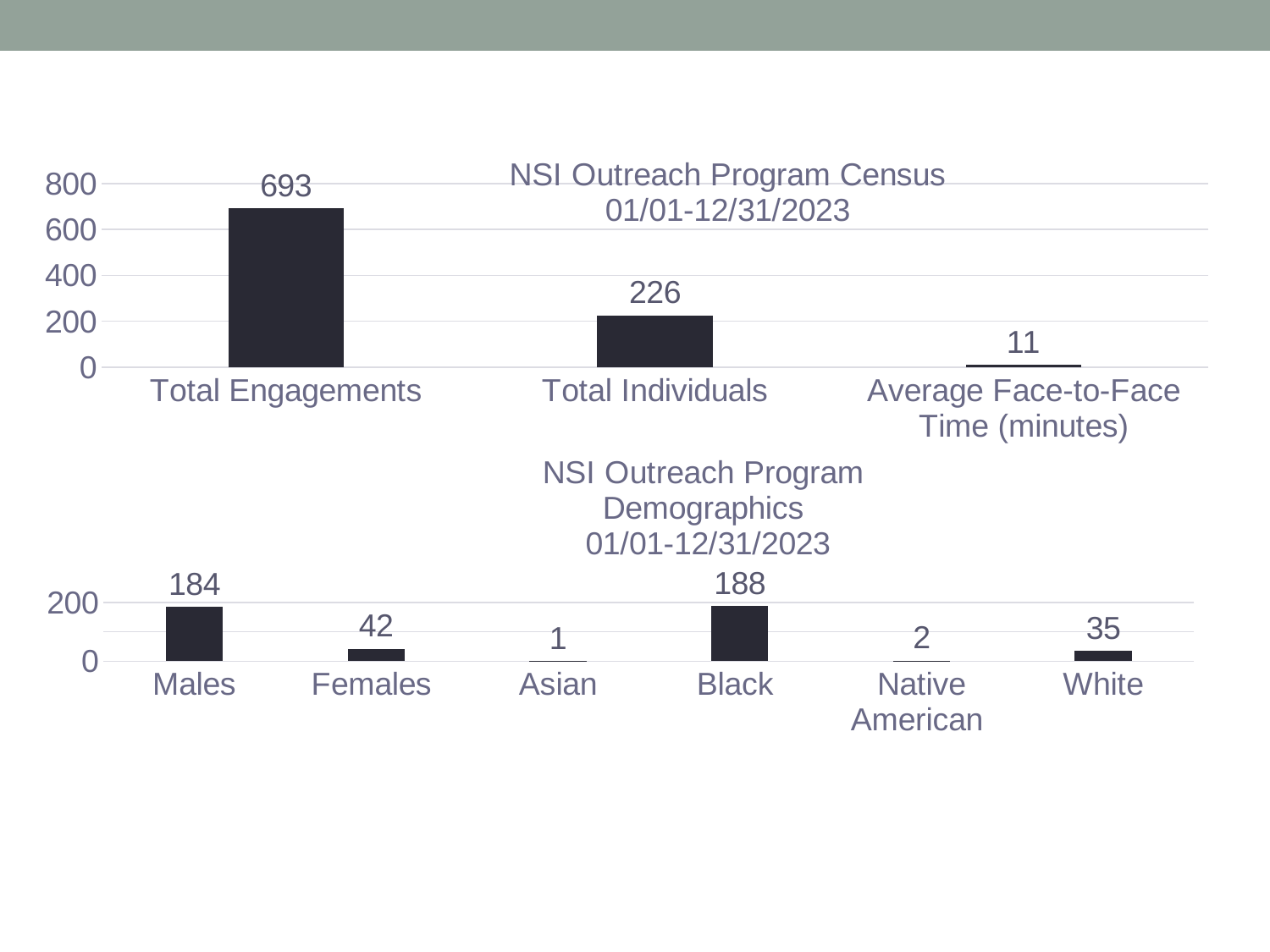
In the NSI Outreach Program Census chart, what is the value for Total Engagements? 693 In the NSI Outreach Program Census chart, what is the Average Face-to-Face Time (minutes)? 11 In the NSI Outreach Program Demographics chart, what is the value for Black? 188 How many categories are shown in the NSI Outreach Program Demographics chart? 6 In the NSI Outreach Program Census chart, what is the value for Total Individuals? 226 In the NSI Outreach Program Demographics chart, what is the value for Males? 184 What type of chart is the NSI Outreach Program Census chart? Bar chart In the NSI Outreach Program Census chart, which category has the highest value? Total Engagements In the NSI Outreach Program Demographics chart, which category has the lowest value? Asian In the NSI Outreach Program Demographics chart, which is larger, Females or White? Females In the NSI Outreach Program Demographics chart, what is the difference between Males and Females? 142 In the NSI Outreach Program Census chart, what is the difference between Total Engagements and Total Individuals? 467